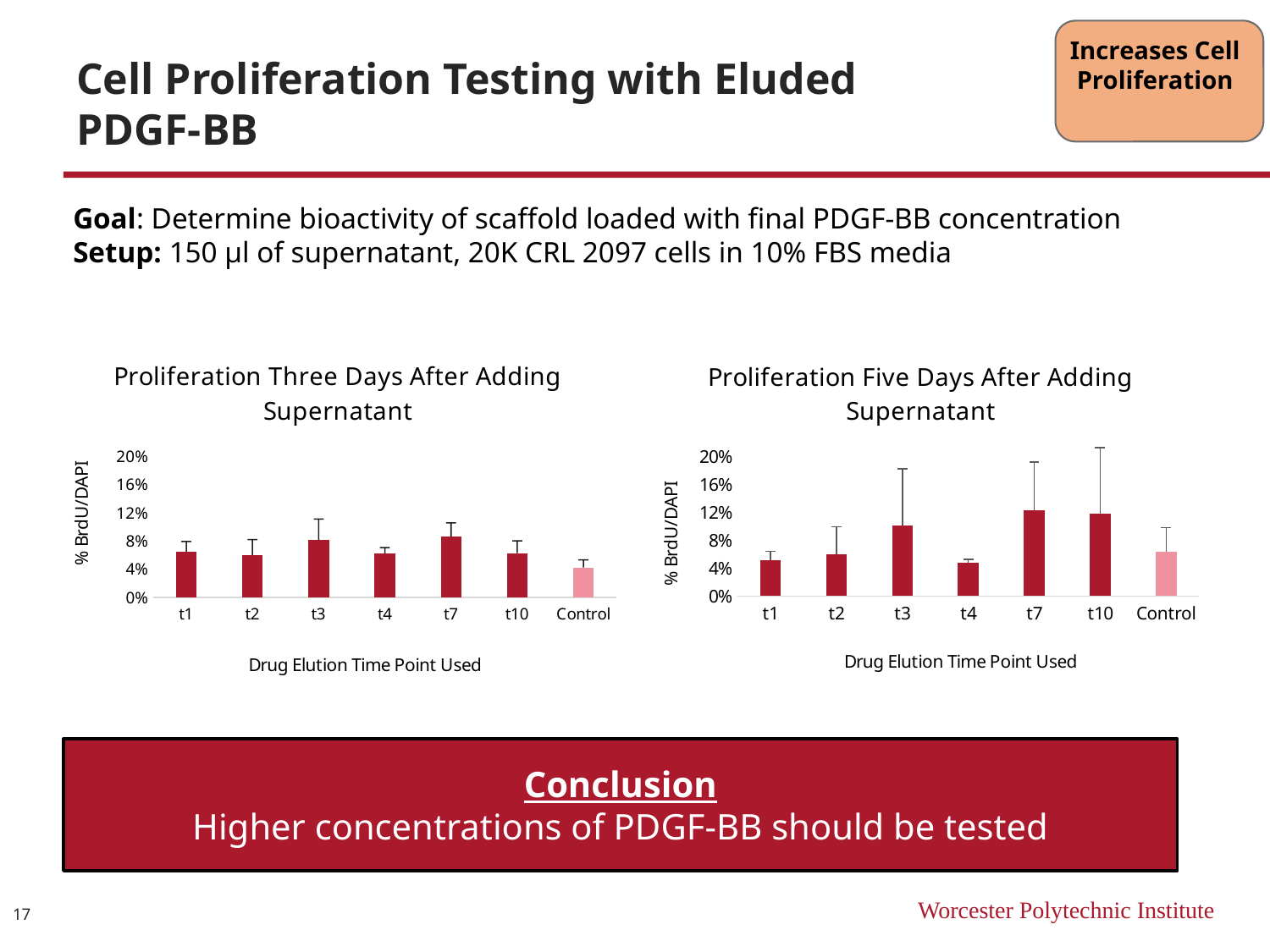
How many categories are shown on the x axis of the 'Proliferation Five Days After Adding Supernatant' chart? 7 In the 'Proliferation Three Days After Adding Supernatant' chart, which is larger, the value for t7 or the value for Control? t7 In the 'Proliferation Five Days After Adding Supernatant' chart, is the value for t4 greater or less than 8%? less What is the y-axis label on the 'Proliferation Five Days After Adding Supernatant' chart? % BrdU/DAPI In the 'Proliferation Three Days After Adding Supernatant' chart, which category has the lowest value? Control In the 'Proliferation Three Days After Adding Supernatant' chart, is the value for t7 greater or less than 4%? greater In the 'Proliferation Five Days After Adding Supernatant' chart, is the value for t7 greater or less than 8%? greater What kind of chart is the 'Proliferation Three Days After Adding Supernatant' chart? bar chart What is the x-axis label on the 'Proliferation Three Days After Adding Supernatant' chart? Drug Elution Time Point Used In the 'Proliferation Five Days After Adding Supernatant' chart, which is larger, the value for t3 or the value for t1? t3 In the 'Proliferation Five Days After Adding Supernatant' chart, which is larger, the value for t10 or the value for t4? t10